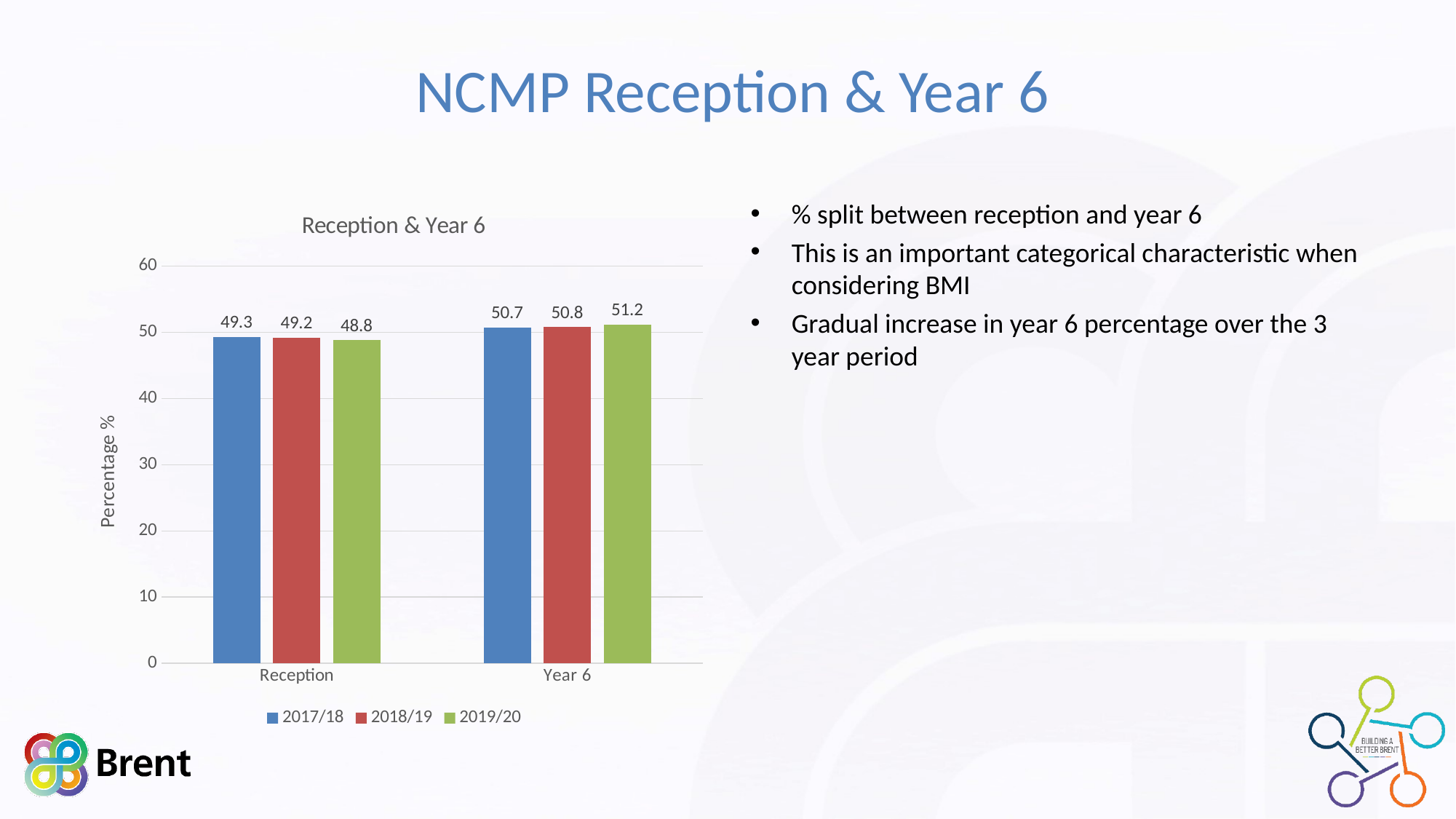
What kind of chart is shown on the slide? bar chart Which category has the highest value in the 2019/20 series? Year 6 What is the value for Year 6 in the 2019/20 series? 51.2 Is the value for Reception in 2019/20 greater or less than 50? less Which category has the lowest value in the 2017/18 series? Reception What is the value for Reception in the 2017/18 series? 49.3 Which is larger: the 2018/19 value for Reception or the 2018/19 value for Year 6? Year 6 What is the value for Reception in the 2019/20 series? 48.8 What is the difference between the Year 6 and Reception values in the 2019/20 series? 2.4 What is the title of the chart? Reception & Year 6 How many series does the legend list? 3 What is the value for Year 6 in the 2018/19 series? 50.8